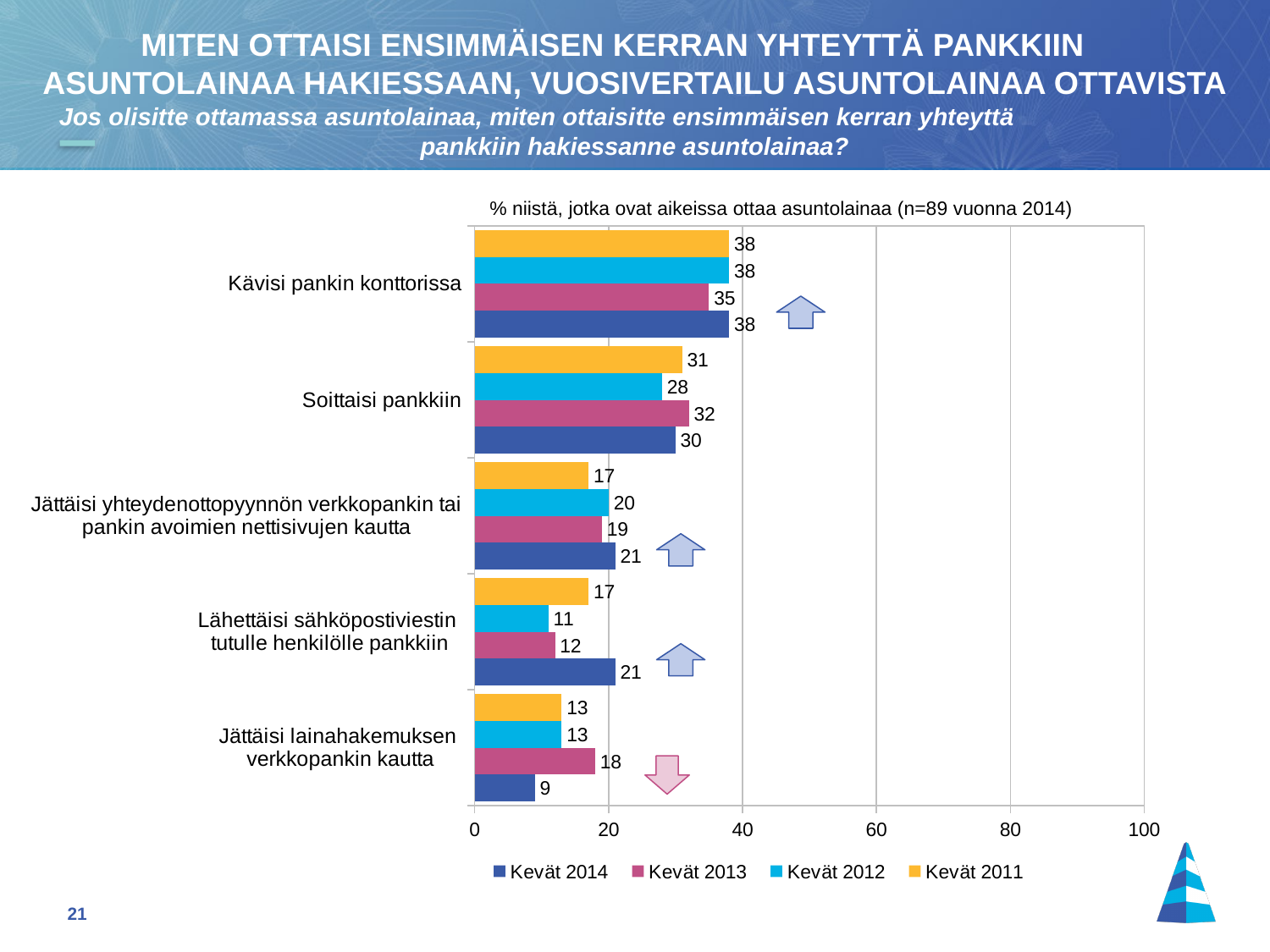
What is the difference between the Kevät 2014 and Kevät 2013 values for "Lähettäisi sähköpostiviestin tutulle henkilölle pankkiin"? 9 What is the Kevät 2013 value for "Soittaisi pankkiin"? 32 What kind of chart is shown on the slide? Bar chart How many categories are shown on the chart? 5 Which category has the highest Kevät 2013 value? Kävisi pankin konttorissa What is the Kevät 2011 value for "Jättäisi lainahakemuksen verkkopankin kautta"? 13 For "Jättäisi lainahakemuksen verkkopankin kautta", which is larger: the Kevät 2013 value or the Kevät 2014 value? Kevät 2013 What is the Kevät 2012 value for "Lähettäisi sähköpostiviestin tutulle henkilölle pankkiin"? 11 Which category has the lowest Kevät 2014 value? Jättäisi lainahakemuksen verkkopankin kautta How many series does the legend list? 4 Is the Kevät 2012 value for "Soittaisi pankkiin" greater or less than 40? less What is the Kevät 2014 value for "Kävisi pankin konttorissa"? 38